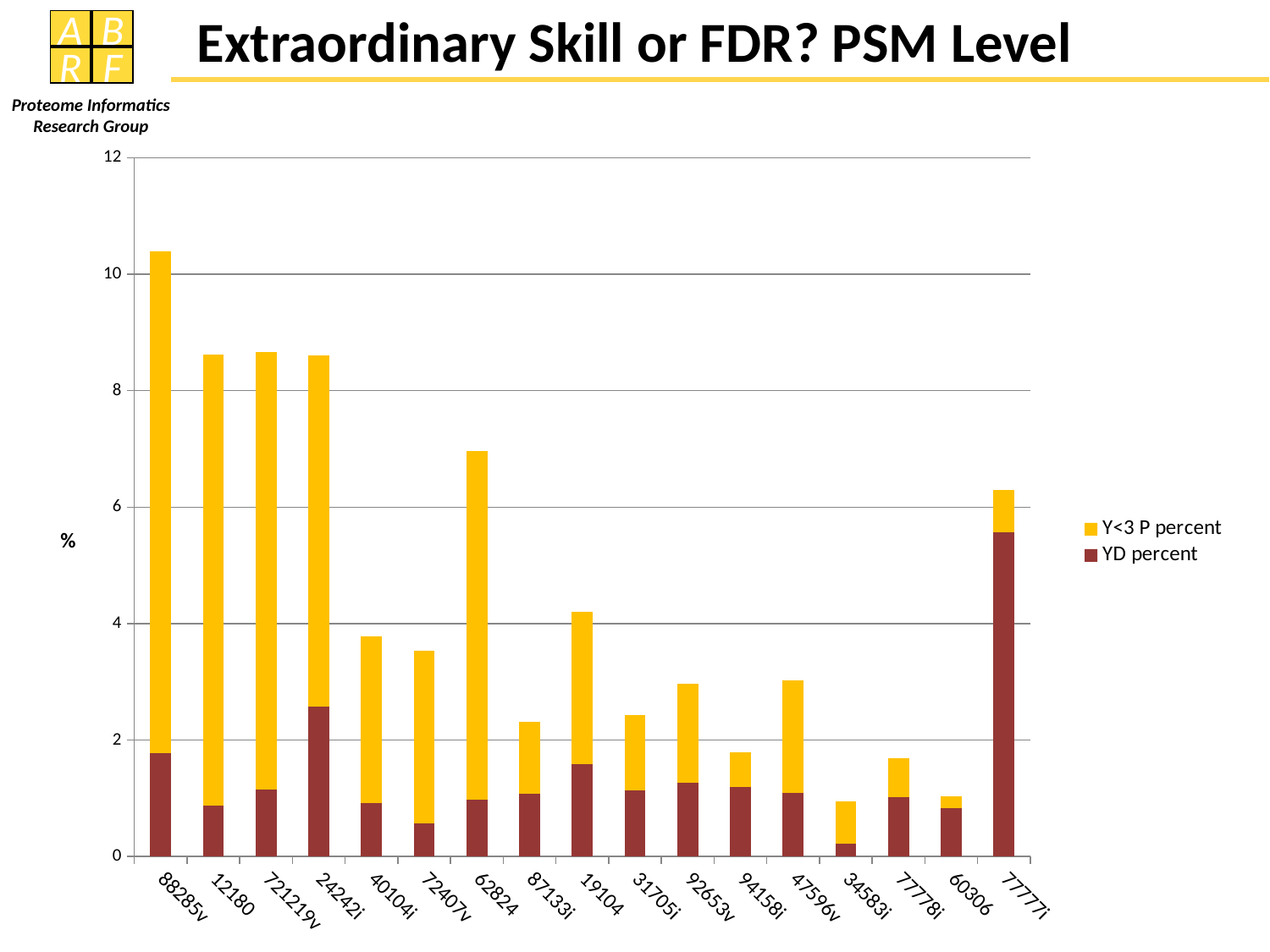
Is the total stacked value for 88285v greater or less than 10? greater Which has the taller stacked bar, 62824 or 19104? 62824 Is the total stacked value for 62824 greater or less than 8? less Which category has the shortest stacked bar overall? 34583i What kind of chart is shown on the slide? Stacked bar chart Which category has the largest YD percent segment? 77777i How many series does the legend list? 2 Which series is shown in yellow in the legend? Y<3 P percent What is the label on the y axis of the chart? % Is the YD percent value for 24242i greater or less than 2? greater Which category has the tallest stacked bar overall? 88285v How many categories are shown along the x axis of the chart? 17